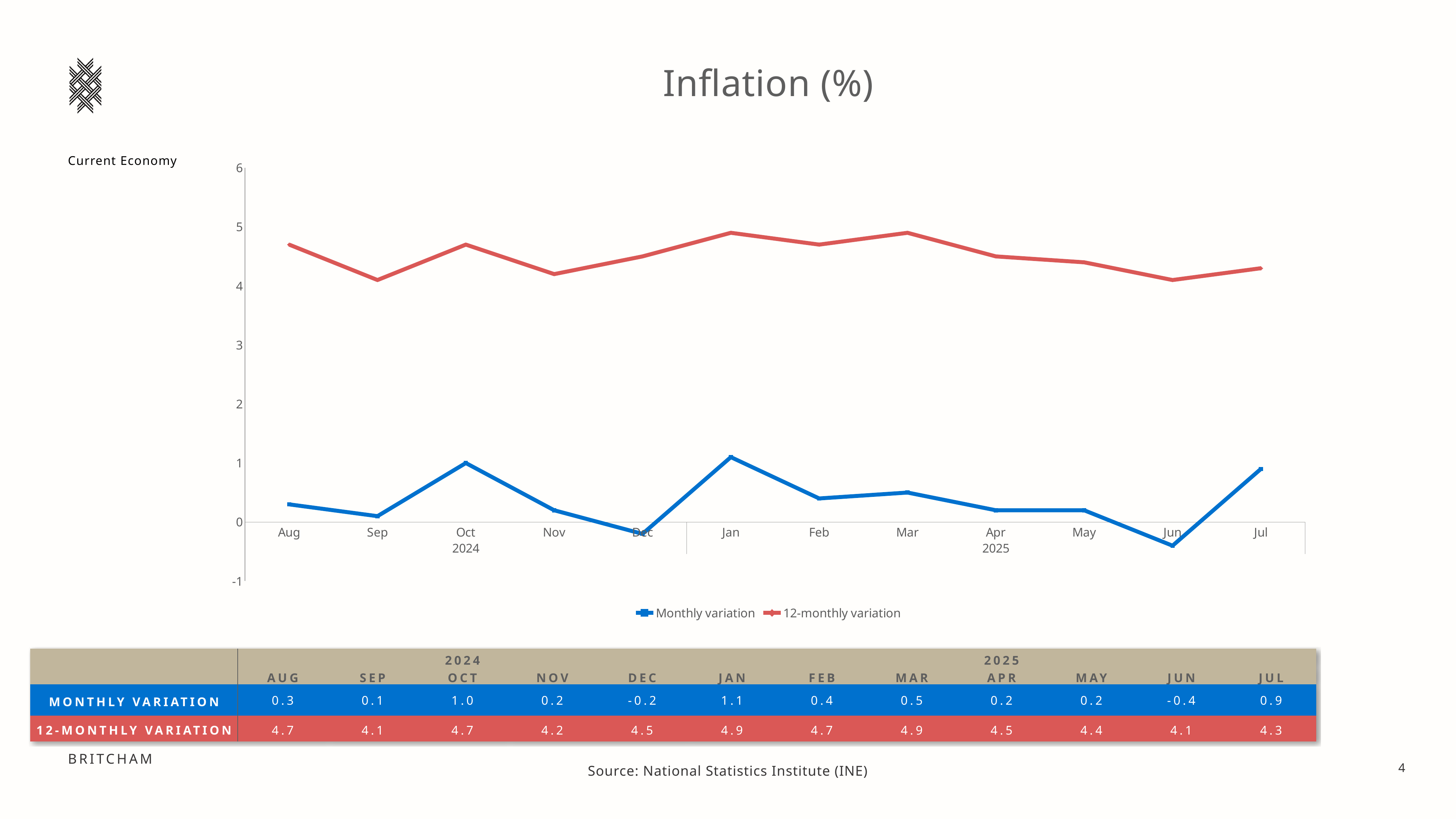
Which is larger, the monthly variation in Oct 2024 or in Jul 2025? Oct 2024 What is the 12-monthly variation for Nov 2024? 4.2 Which month has the lowest monthly variation? Jun 2025 Which month has the highest monthly variation? Jan 2025 What is the monthly variation for Jan 2025? 1.1 What is the monthly variation for Dec 2024? -0.2 Is the 12-monthly variation for Jan 2025 greater or less than 4? greater What is the title of the chart? Inflation (%) What is the difference between the 12-monthly variation in Mar 2025 and Jun 2025? 0.8 How many series does the legend list? 2 What type of chart is shown on the slide? Line chart How many months are plotted on the x axis? 12